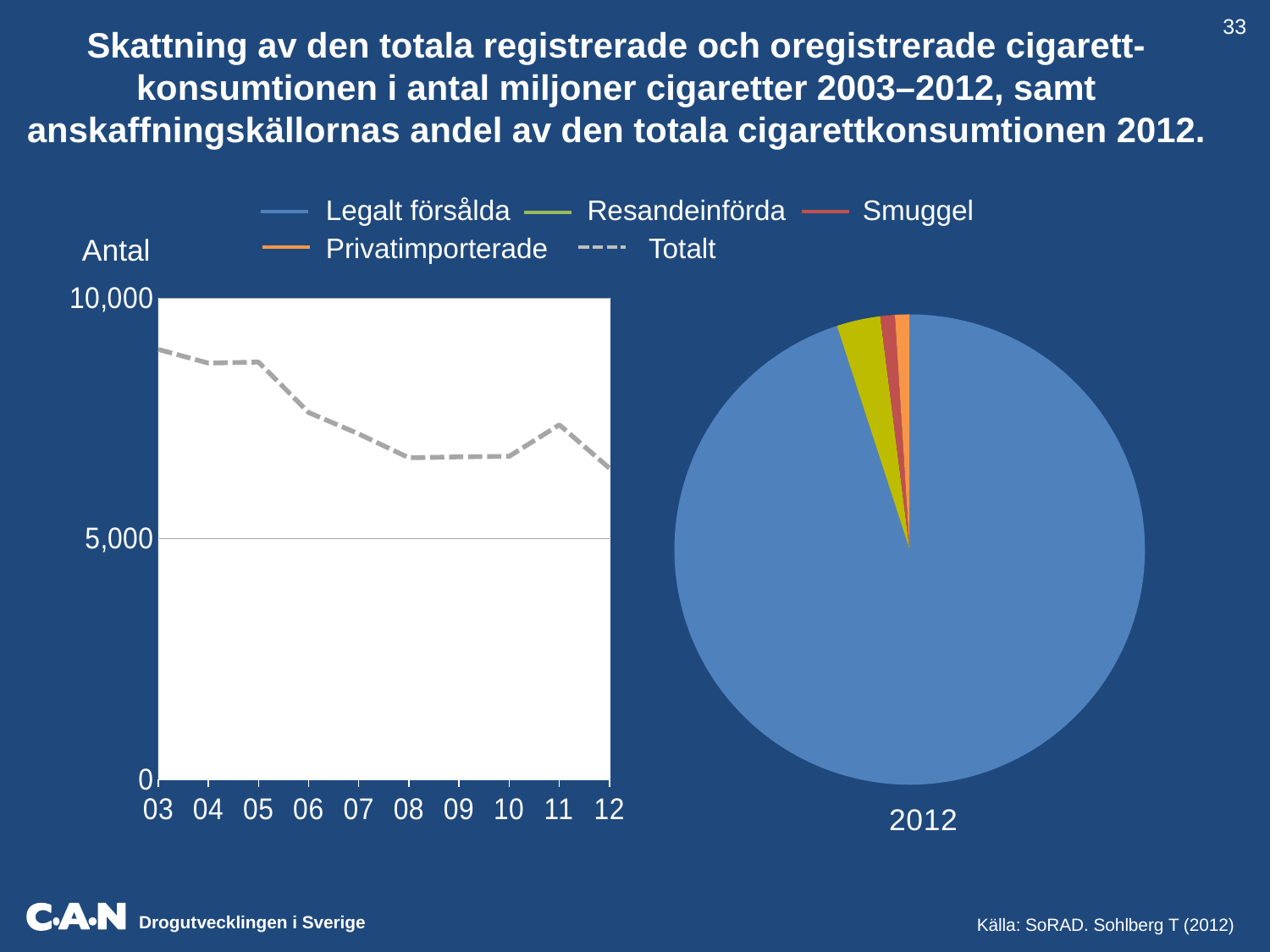
In the line chart on the left, how many years are shown on the x axis? 10 Which year is labelled under the pie chart on the right? 2012 What kind of chart is the chart on the left side of the slide? line chart In the line chart on the left, is the Totalt value for 03 greater or less than 5,000? greater In the pie chart on the right, which source has the largest slice? Legalt försålda How many series does the legend list? 5 In the line chart on the left, is the Totalt value for 12 greater or less than 10,000? less What kind of chart is the chart on the right side of the slide? pie chart In the line chart on the left, does the Totalt line rise or fall from 03 to 08? fall In the line chart on the left, which year has the higher Totalt value, 10 or 11? 11 In the line chart on the left, which year has the higher Totalt value, 03 or 12? 03 In the line chart on the left, which year has the highest Totalt value? 03